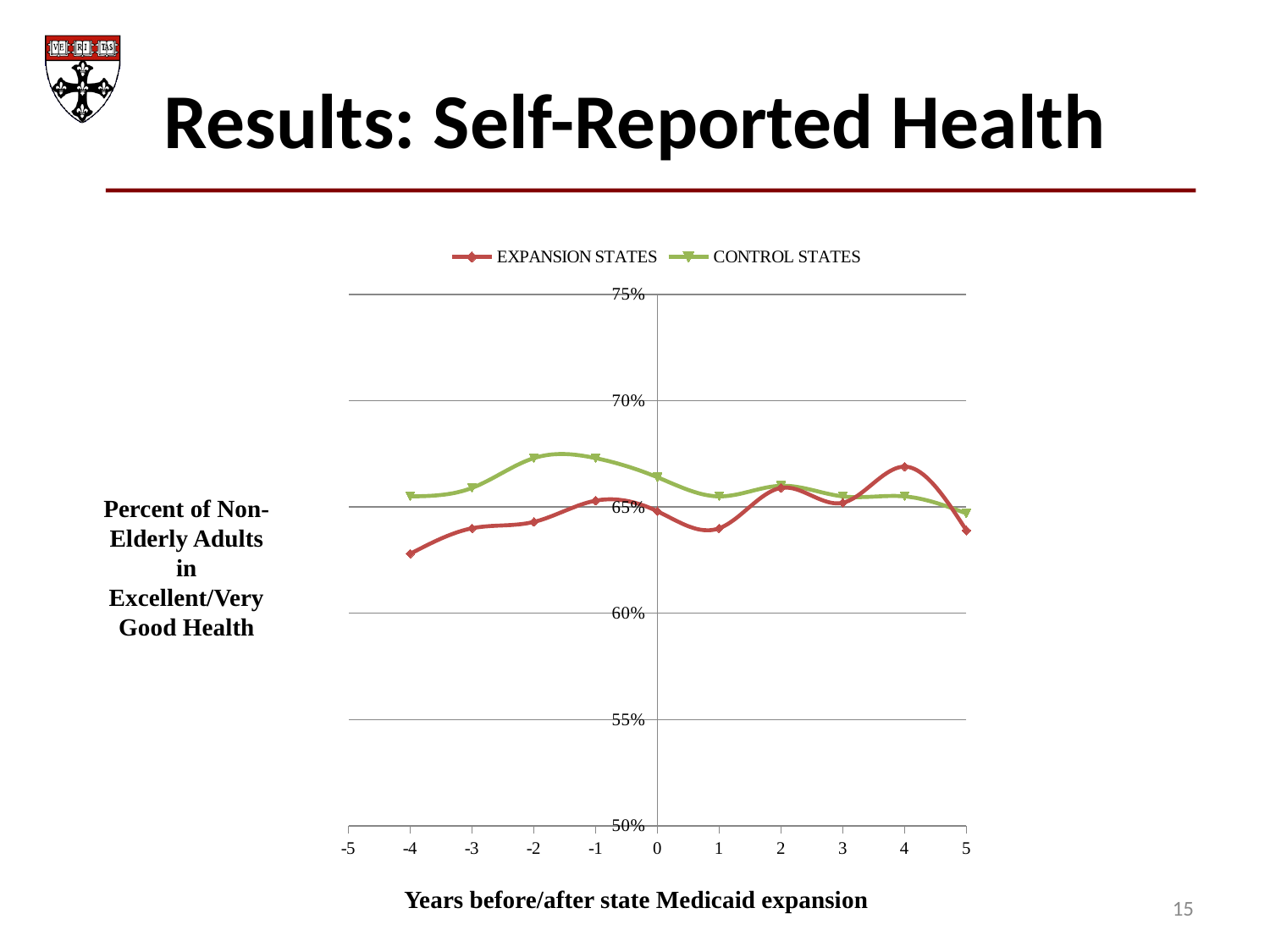
How many data points are plotted for the Expansion States series? 10 Is the value for Expansion States at year -4 greater or less than 65%? less Is the value for Expansion States at year 4 greater or less than 65%? greater Is the value for Expansion States at year 1 greater or less than 65%? less What is the title of the x axis? Years before/after state Medicaid expansion At year -4, which series has the higher value, Expansion States or Control States? Control States At year 4, which series has the higher value, Expansion States or Control States? Expansion States How many series does the legend list? 2 What kind of chart is shown on the slide? Line chart Does the Expansion States series rise or fall from year -4 to year -1? Rise At which year does the Expansion States series reach its lowest value? -4